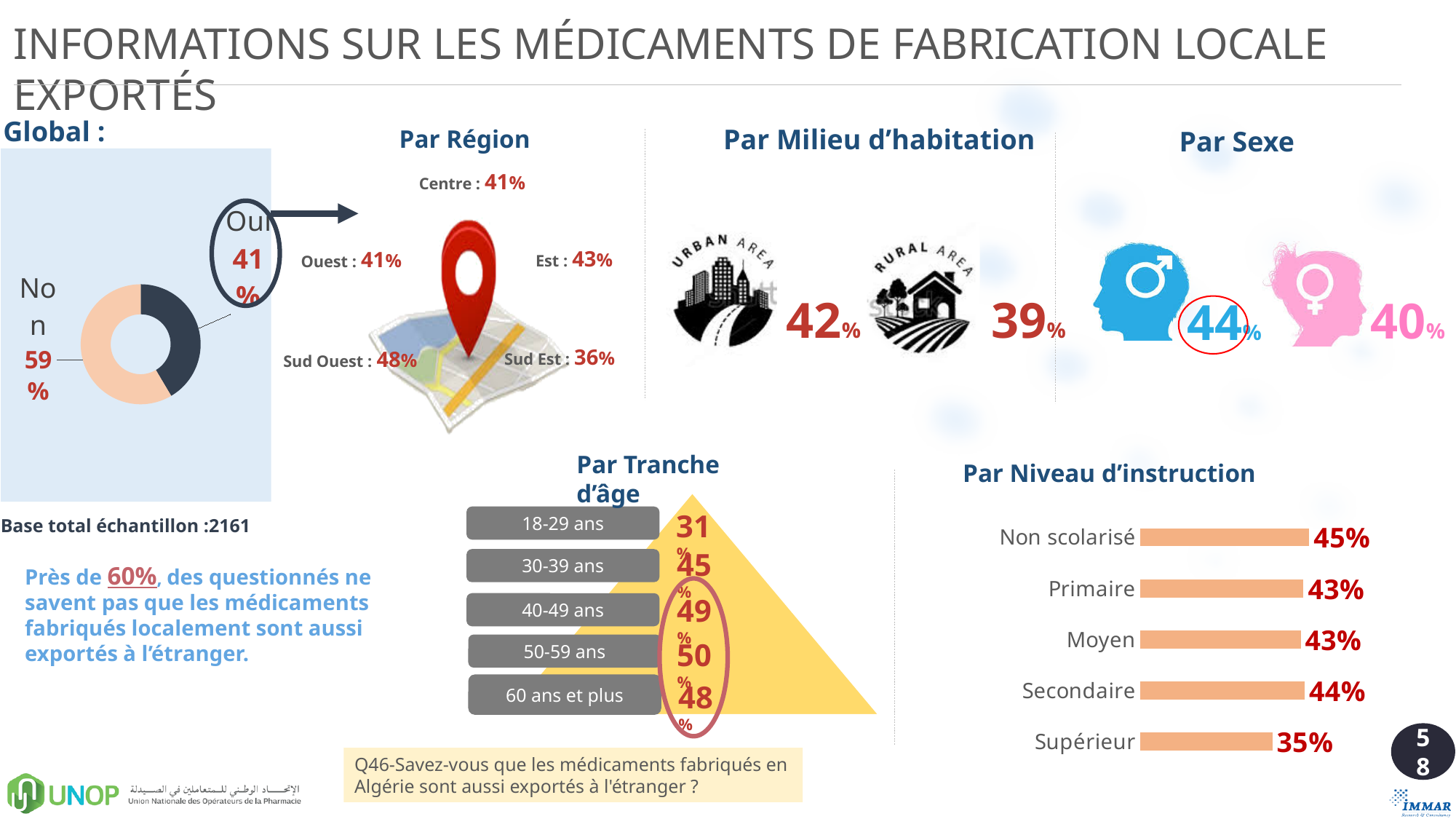
In the Global donut chart, what is the value for Oui? 41% What kind of chart is the Global chart on the left of the slide? doughnut chart How many categories does the Global donut chart show? 2 In the Par Niveau d'instruction chart, which category has the highest value? Non scolarisé In the Par Niveau d'instruction chart, what is the difference between Non scolarisé and Supérieur? 10 percentage points In the Par Tranche d'âge chart, which age group has the highest value? 50-59 ans How many categories are shown in the Par Niveau d'instruction chart? 5 In the Par Niveau d'instruction chart, what is the value for Supérieur? 35% What kind of chart is the Par Niveau d'instruction chart? bar chart In the Global donut chart, what is the value for Non? 59% In the Par Niveau d'instruction chart, which category has the lowest value? Supérieur In the Par Région section, which region has the highest value? Sud Ouest